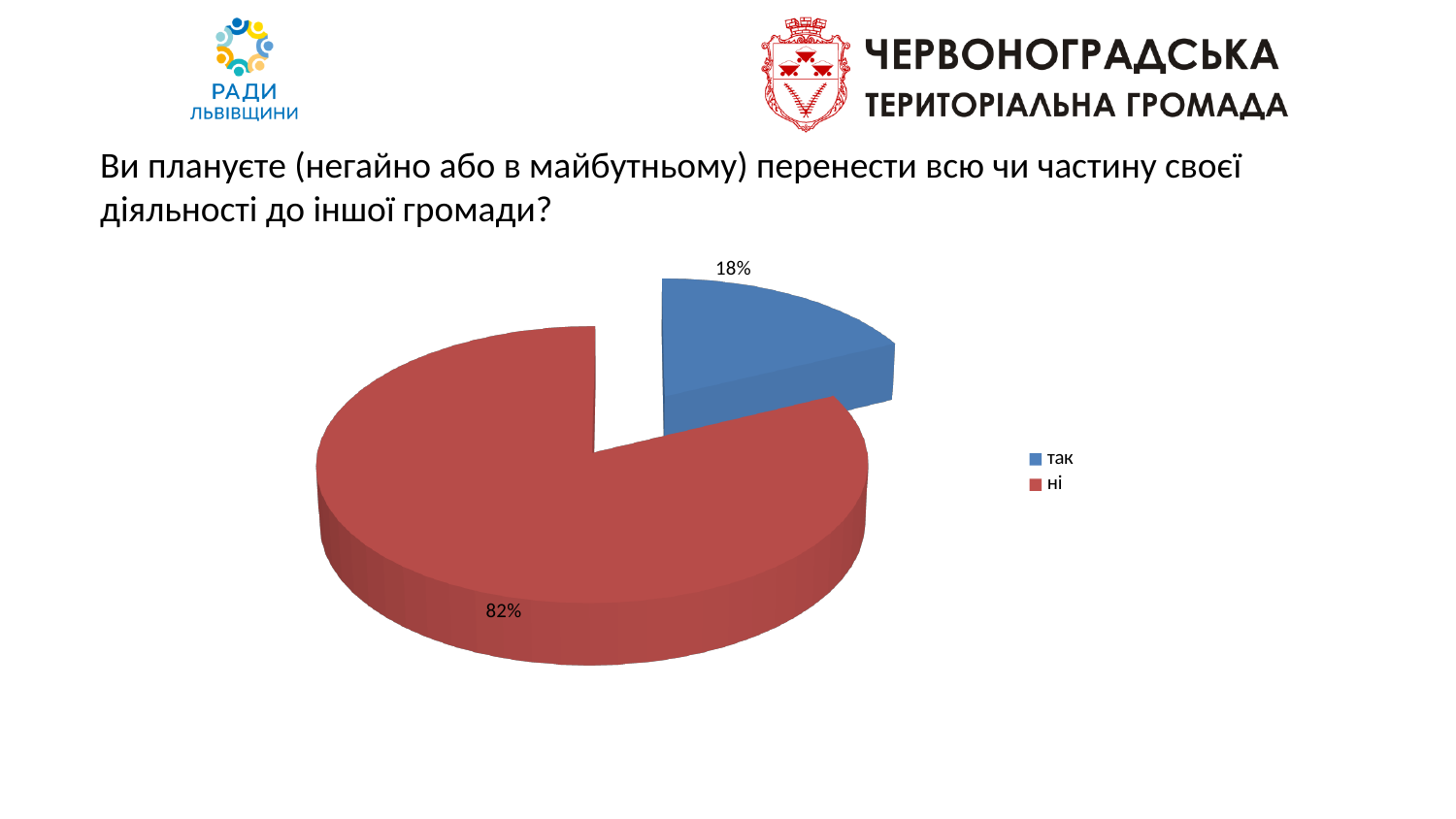
Which is larger, the "так" slice or the "ні" slice? ні What kind of chart is shown on the slide? pie chart Which slice is the smallest in the pie chart? так What share of the pie does the "так" slice represent? 18% What share of the pie does the "ні" slice represent? 82% How many slices does the pie chart have? 2 Which slice is the largest in the pie chart? ні What colour is the "так" slice? blue How many entries does the legend list? 2 What colour is the "ні" slice? red What is the difference in percentage points between the "ні" and "так" slices? 64